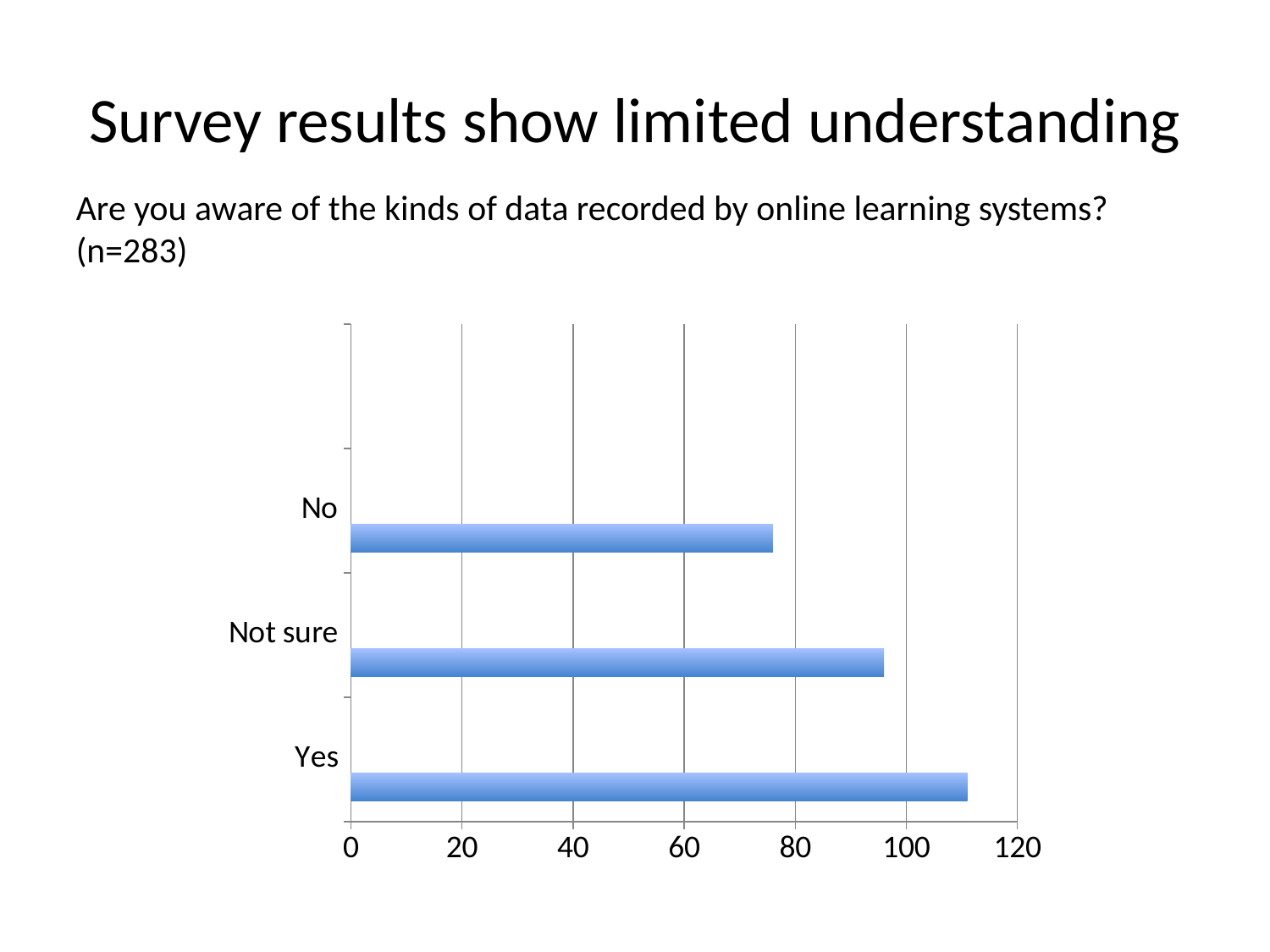
Which response category has the lowest value? No What is the maximum value shown on the horizontal axis? 120 Which response category has the highest value? Yes Is the value for No greater or less than 60? greater Is the value for No greater or less than 80? less What kind of chart is shown on the slide? bar chart Which is larger, the value for Not sure or the value for No? Not sure Is the value for Yes greater or less than 100? greater Which is larger, the value for Yes or the value for Not sure? Yes How many bars are plotted in the chart? 3